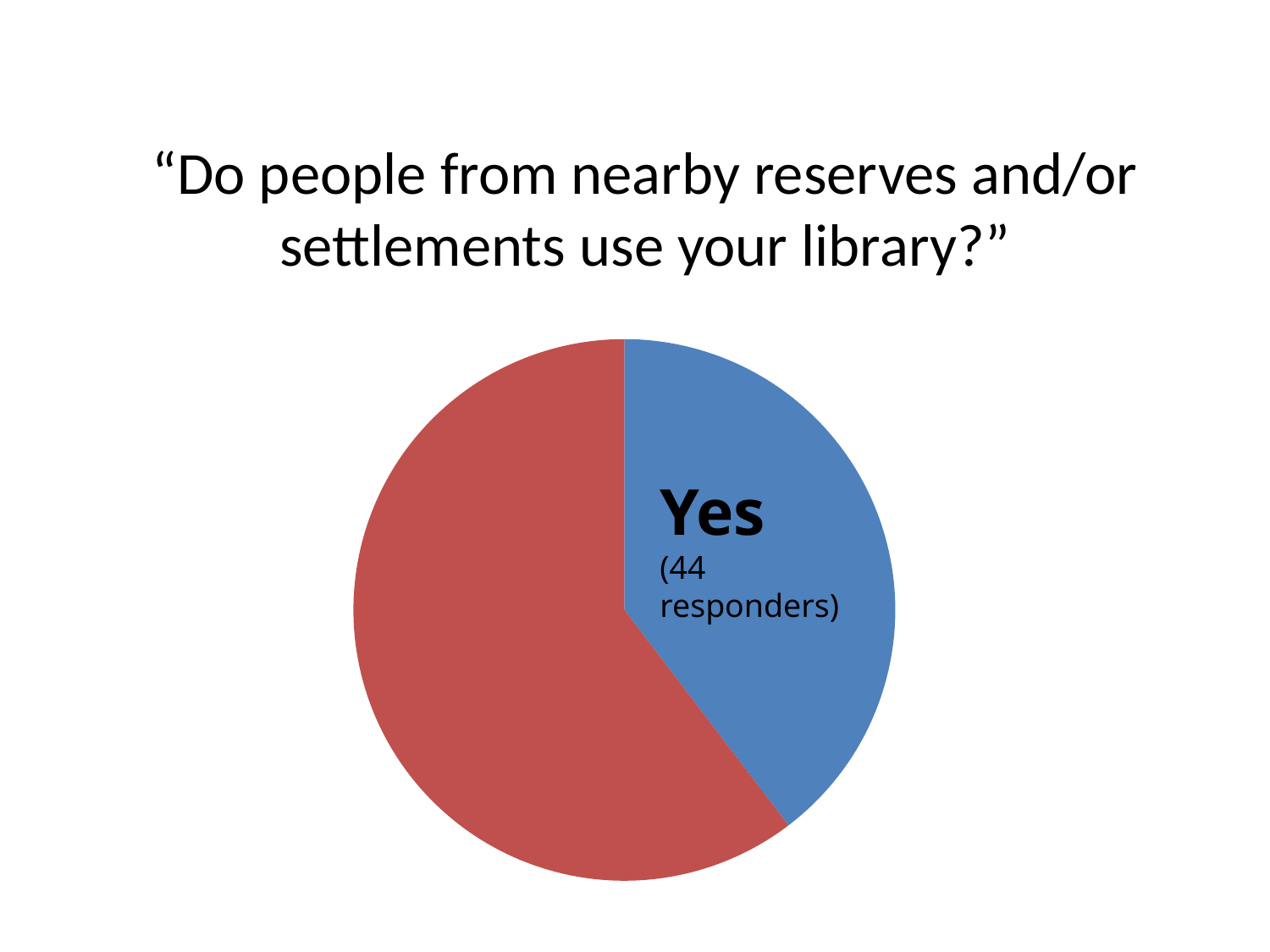
How many responders answered "Yes" according to the pie chart? 44 responders How many slices does the pie chart have? 2 Which slice is labelled with a value in the pie chart? Yes Is the "Yes" slice the larger or the smaller of the two slices? smaller Does the "Yes" slice take up more or less than half of the pie? less What colour is the "Yes" slice in the pie chart? blue What kind of chart is shown on the slide? pie chart Which slice is larger, the blue slice or the red slice? the red slice